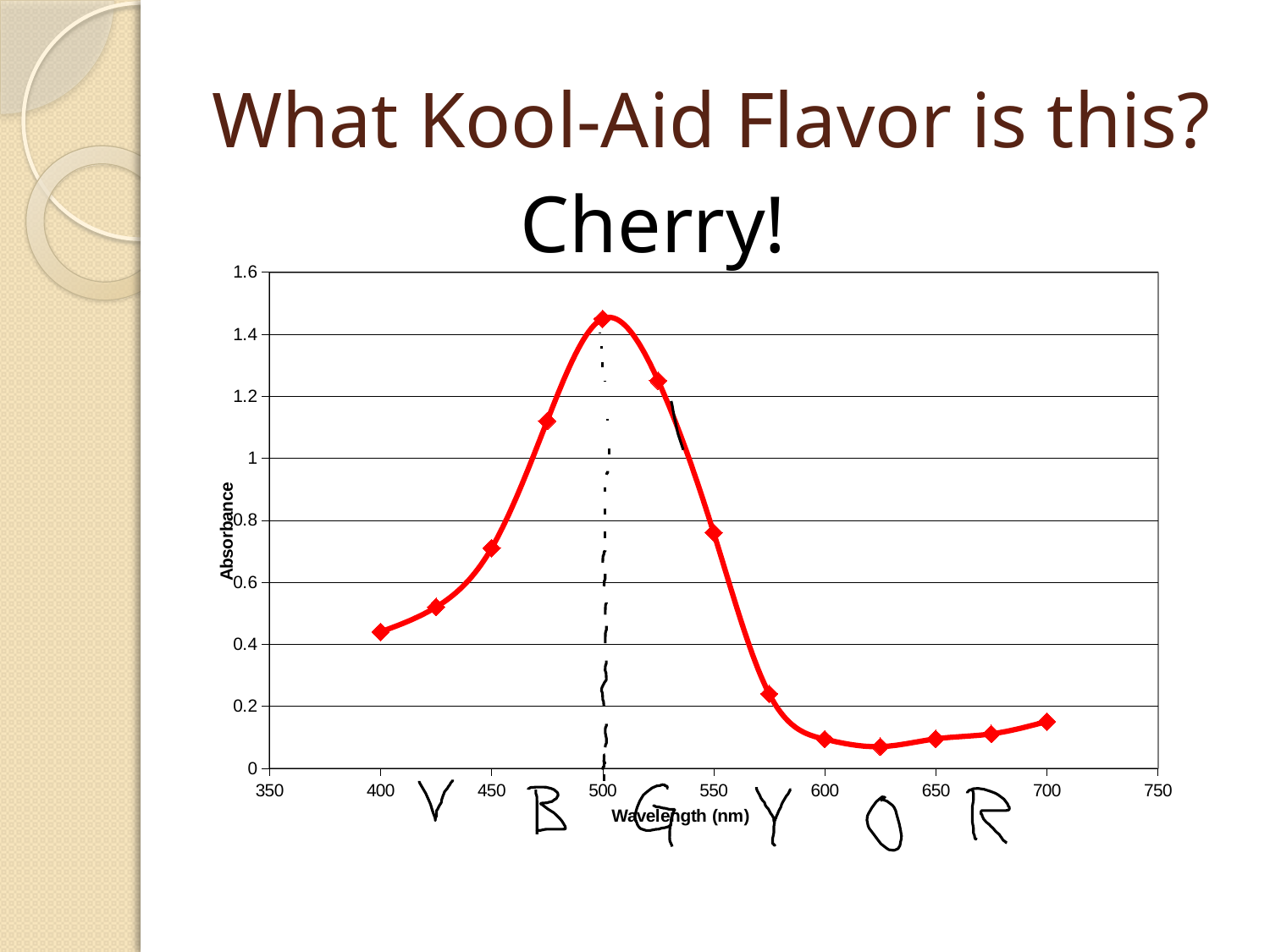
At which wavelength does the absorbance reach its highest value? 500 Is the absorbance at 550 nm greater or less than 0.8? less Is the absorbance at 400 nm greater or less than 0.4? greater Is the absorbance at 500 nm greater or less than 1.4? greater What is the title of the x axis? Wavelength (nm) What kind of chart is shown on the slide? line chart Does the absorbance rise or fall as the wavelength increases from 500 nm to 600 nm? fall How many data points are plotted on the curve? 13 Does the absorbance rise or fall as the wavelength increases from 400 nm to 500 nm? rise Which has the higher absorbance, 475 nm or 550 nm? 475 nm